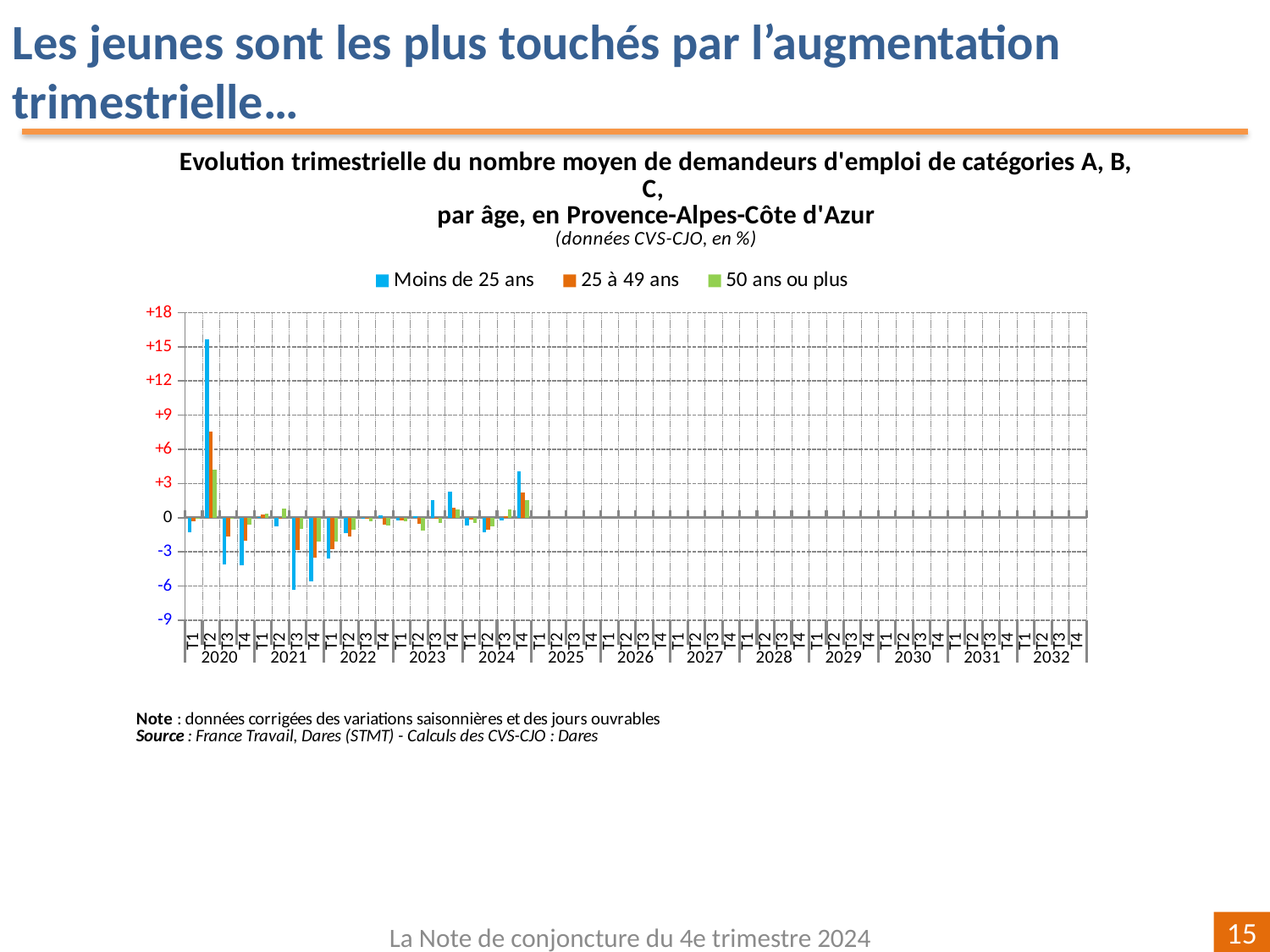
Which series is shown in blue in the legend? Moins de 25 ans Is the value for '25 à 49 ans' in T2 2020 greater or less than +6? greater Is the value for 'Moins de 25 ans' in T3 2021 greater or less than -3? less Is the value for 'Moins de 25 ans' in T2 2020 greater or less than +12? greater What kind of chart is shown on the slide? bar chart What region does the chart title say the data covers? Provence-Alpes-Côte d'Azur How many years are labelled along the x axis? 13 In which quarter does the 'Moins de 25 ans' series reach its highest value? T2 2020 How many series does the legend list? 3 In T2 2020, which series has the larger value: 'Moins de 25 ans' or '25 à 49 ans'? Moins de 25 ans